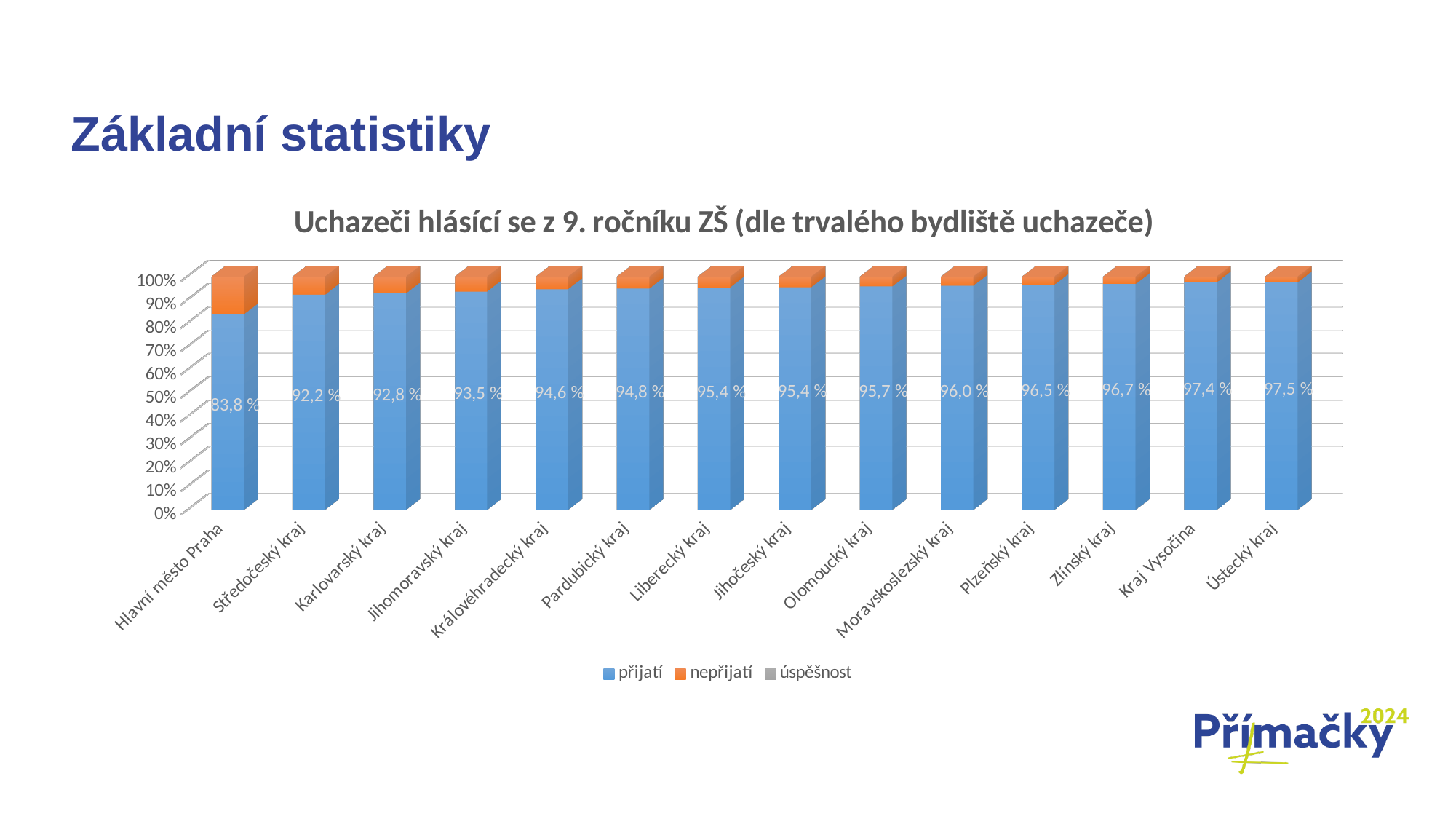
Which region has the lowest percentage label on its bar? Hlavní město Praha What percentage label is shown on the bar for Hlavní město Praha? 83,8 % Which region has the highest percentage label on its bar? Ústecký kraj What is the difference between the percentage labels for Ústecký kraj and Hlavní město Praha? 13,7 % Do the percentage labels rise or fall from left to right along the x axis? Rise How many regions are shown on the x axis of the chart? 14 Which has a larger percentage label, Plzeňský kraj or Karlovarský kraj? Plzeňský kraj What percentage label is shown on the bar for Ústecký kraj? 97,5 % How many series does the legend list? 3 What kind of chart is shown on the slide? Stacked bar chart What percentage label is shown on the bar for Olomoucký kraj? 95,7 % What percentage label is shown on the bar for Středočeský kraj? 92,2 %